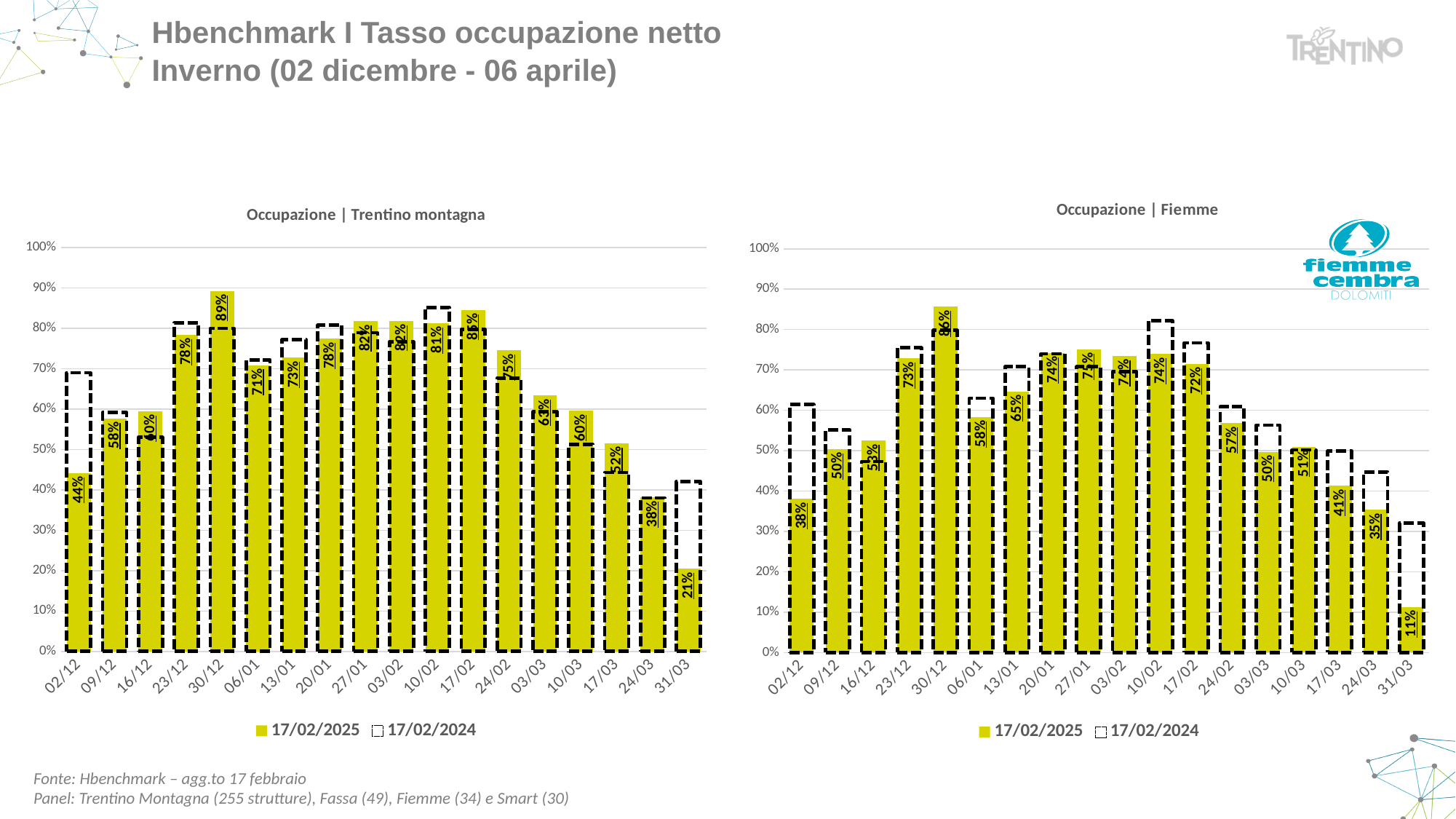
How many series does the legend of the 'Occupazione | Trentino montagna' chart list? 2 In the 'Occupazione | Trentino montagna' chart, is the 17/02/2024 value for 02/12 greater or less than 60%? greater In the 'Occupazione | Fiemme' chart, which date has the highest 17/02/2025 value? 30/12 What kind of chart is the 'Occupazione | Trentino montagna' chart? Bar chart In the 'Occupazione | Trentino montagna' chart, which date has the highest 17/02/2025 value? 30/12 How many date categories are shown on the x axis of the 'Occupazione | Fiemme' chart? 18 In the 'Occupazione | Trentino montagna' chart, what is the 17/02/2025 value for 30/12? 89% In the 'Occupazione | Fiemme' chart, which has the larger 17/02/2025 value, 23/12 or 06/01? 23/12 In the 'Occupazione | Trentino montagna' chart, which date has the lowest 17/02/2025 value? 31/03 In the 'Occupazione | Fiemme' chart, what is the 17/02/2025 value for 31/03? 11% In the 'Occupazione | Trentino montagna' chart, what is the difference between the 17/02/2025 values for 30/12 and 02/12? 45 percentage points In the 'Occupazione | Fiemme' chart, do the 17/02/2025 values rise or fall from 17/02 to 31/03? Fall